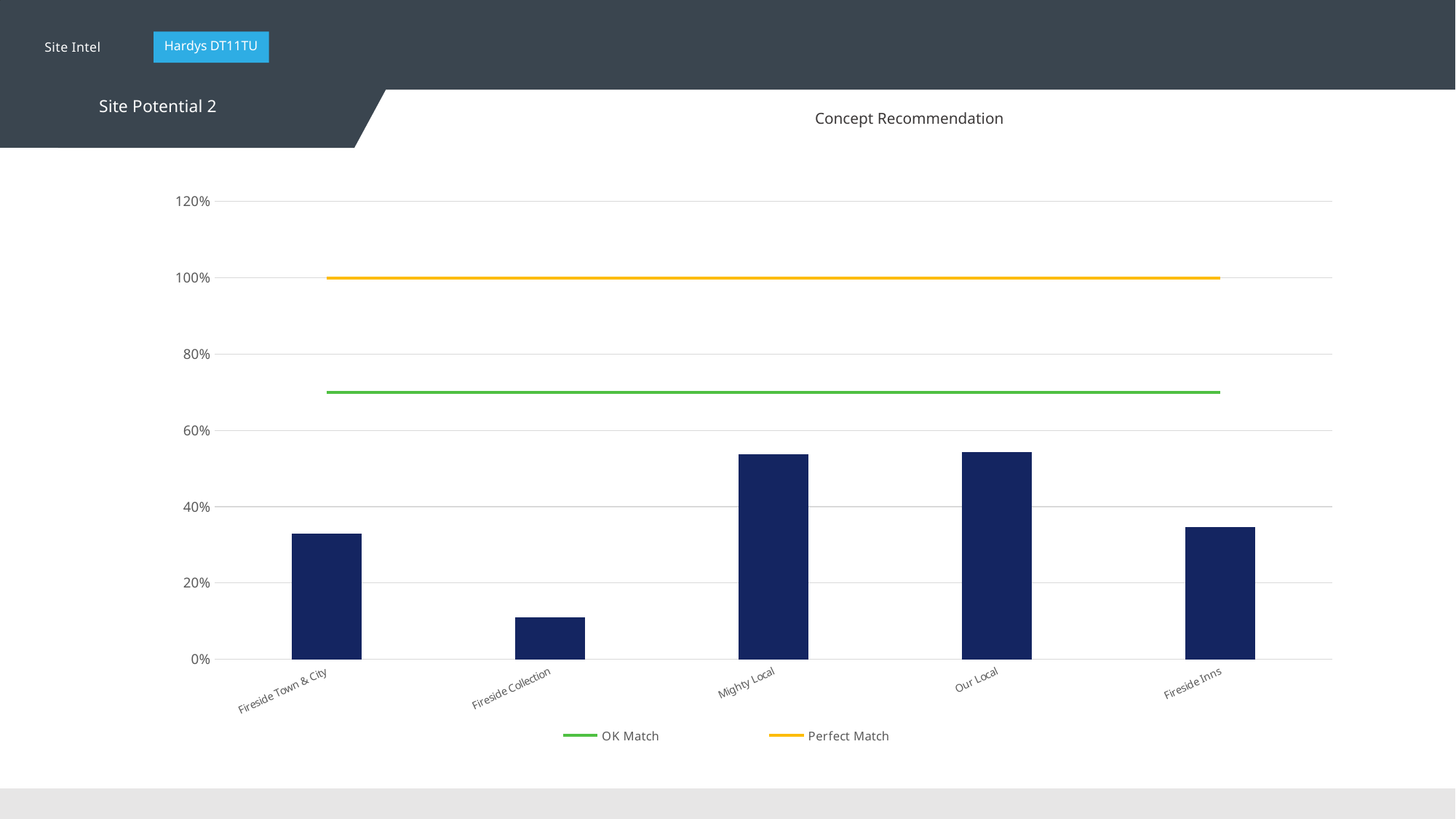
At what value on the y axis does the Perfect Match line sit? 100% What is the title of the chart? Concept Recommendation Is the value for Fireside Town & City greater or less than 40%? less How many categories are shown on the x axis of the chart? 5 Is the value for Fireside Collection greater or less than 20%? less Which is larger, the value for Fireside Inns or the value for Fireside Collection? Fireside Inns Which is larger, the value for Fireside Town & City or the value for Our Local? Our Local What kind of chart is shown on the slide? bar chart Is the value for Mighty Local greater or less than 40%? greater Which category has the lowest bar in the chart? Fireside Collection How many entries does the chart's legend list? 2